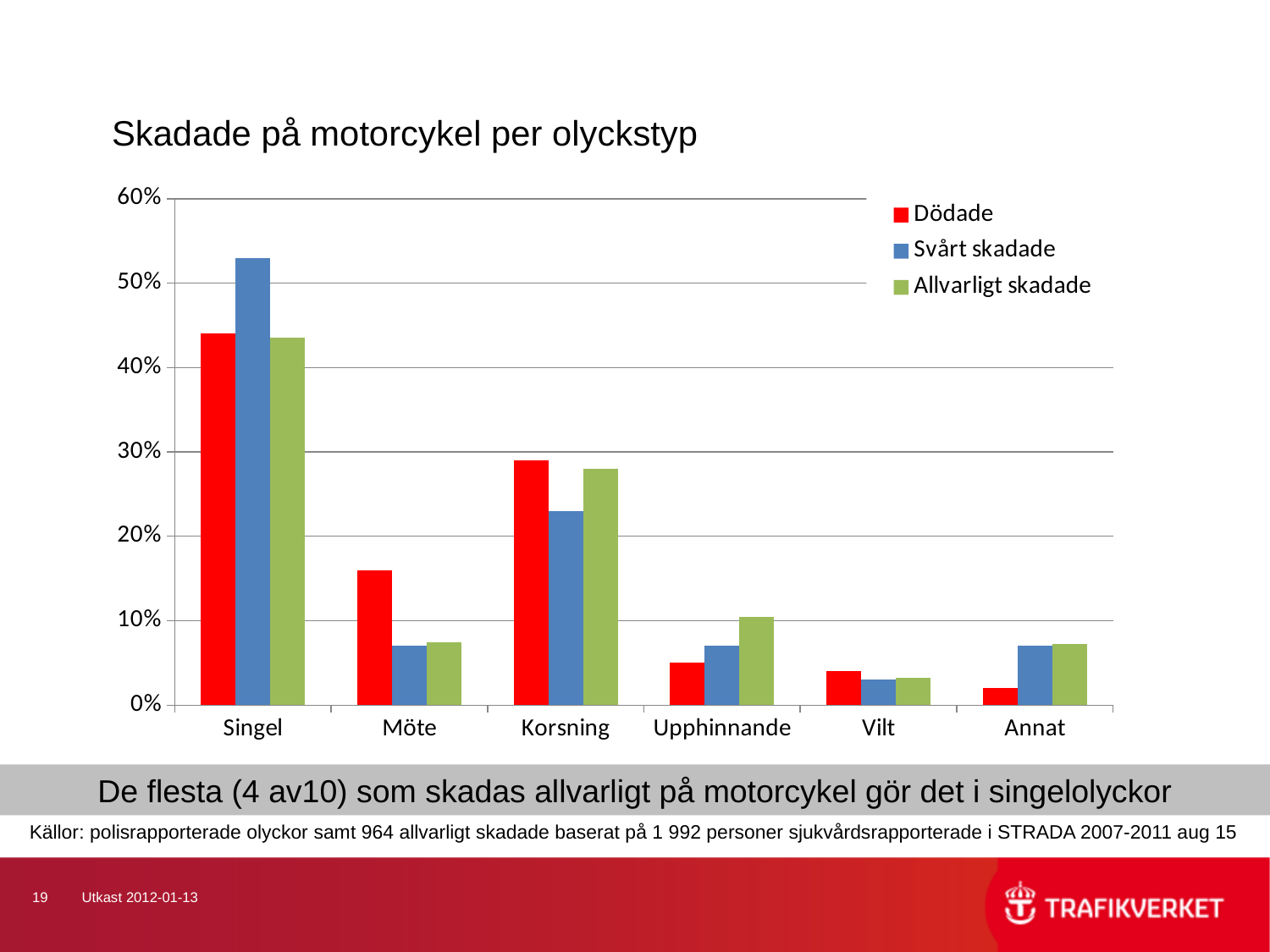
How many series does the legend list? 3 For Möte, which is larger: Dödade or Svårt skadade? Dödade Which category has the lowest value for Dödade? Annat For Korsning, which is larger: Dödade or Svårt skadade? Dödade Which category has the highest value for Svårt skadade? Singel What kind of chart is shown on the slide? bar chart Is the value for Dödade in Möte greater or less than 10%? greater Is the value for Dödade in Korsning greater or less than 20%? greater How many accident-type categories are shown on the x axis? 6 What is the title of the chart? Skadade på motorcykel per olyckstyp Is the value for Svårt skadade in Singel greater or less than 50%? greater Which category has the highest value for Dödade? Singel